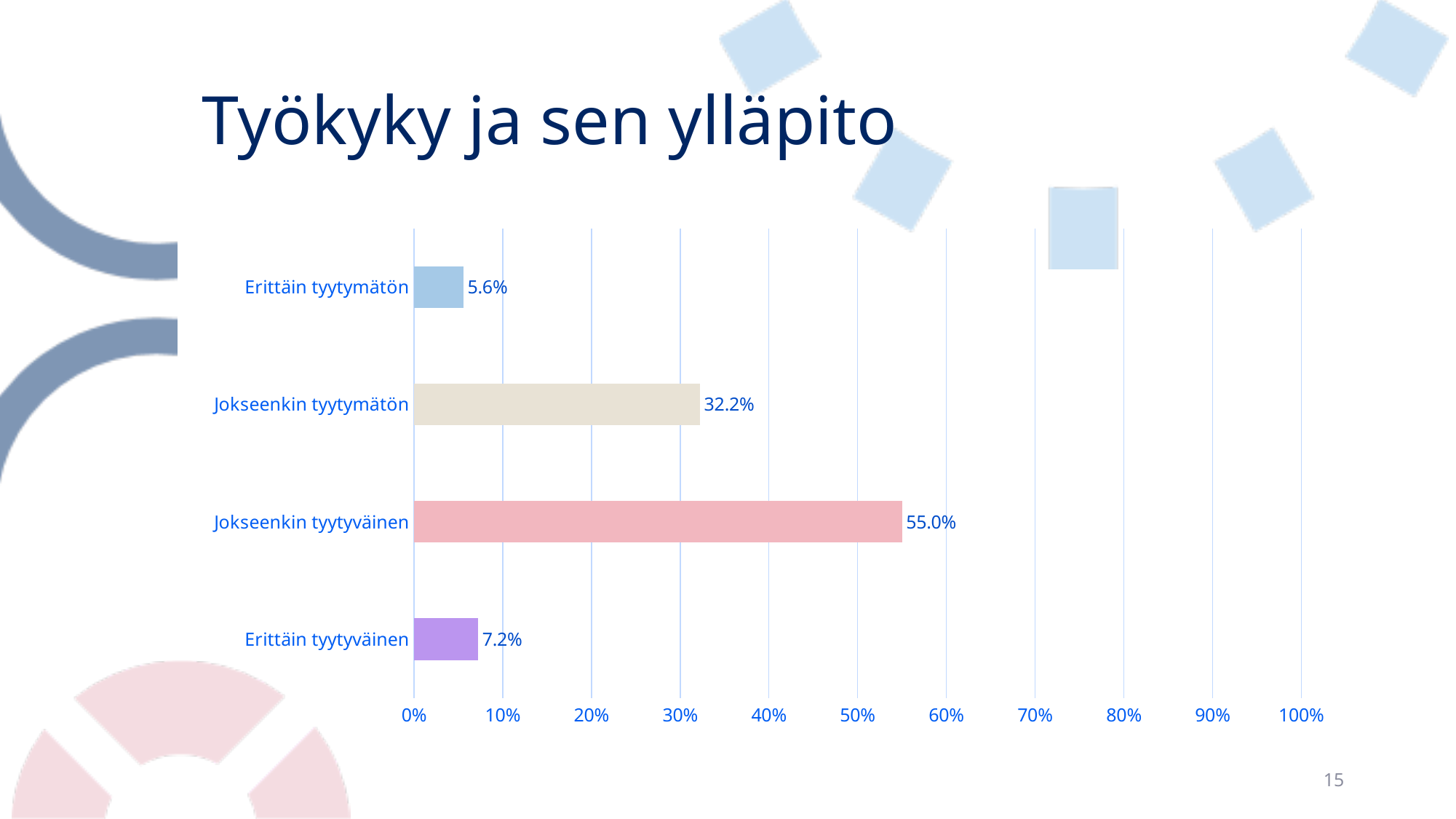
Is the value for Jokseenkin tyytymätön greater or less than 40%? less What is the value for Erittäin tyytymätön? 5.6% What is the value for Erittäin tyytyväinen? 7.2% What is the difference between the values for Erittäin tyytyväinen and Erittäin tyytymätön? 1.6% Which category has the lowest value? Erittäin tyytymätön Which is larger, the value for Erittäin tyytyväinen or the value for Erittäin tyytymätön? Erittäin tyytyväinen What is the difference between the values for Jokseenkin tyytyväinen and Jokseenkin tyytymätön? 22.8% What kind of chart is shown on the slide? bar chart What is the value for Jokseenkin tyytyväinen? 55.0% How many categories are shown in the chart? 4 Which category has the highest value? Jokseenkin tyytyväinen What is the value for Jokseenkin tyytymätön? 32.2%